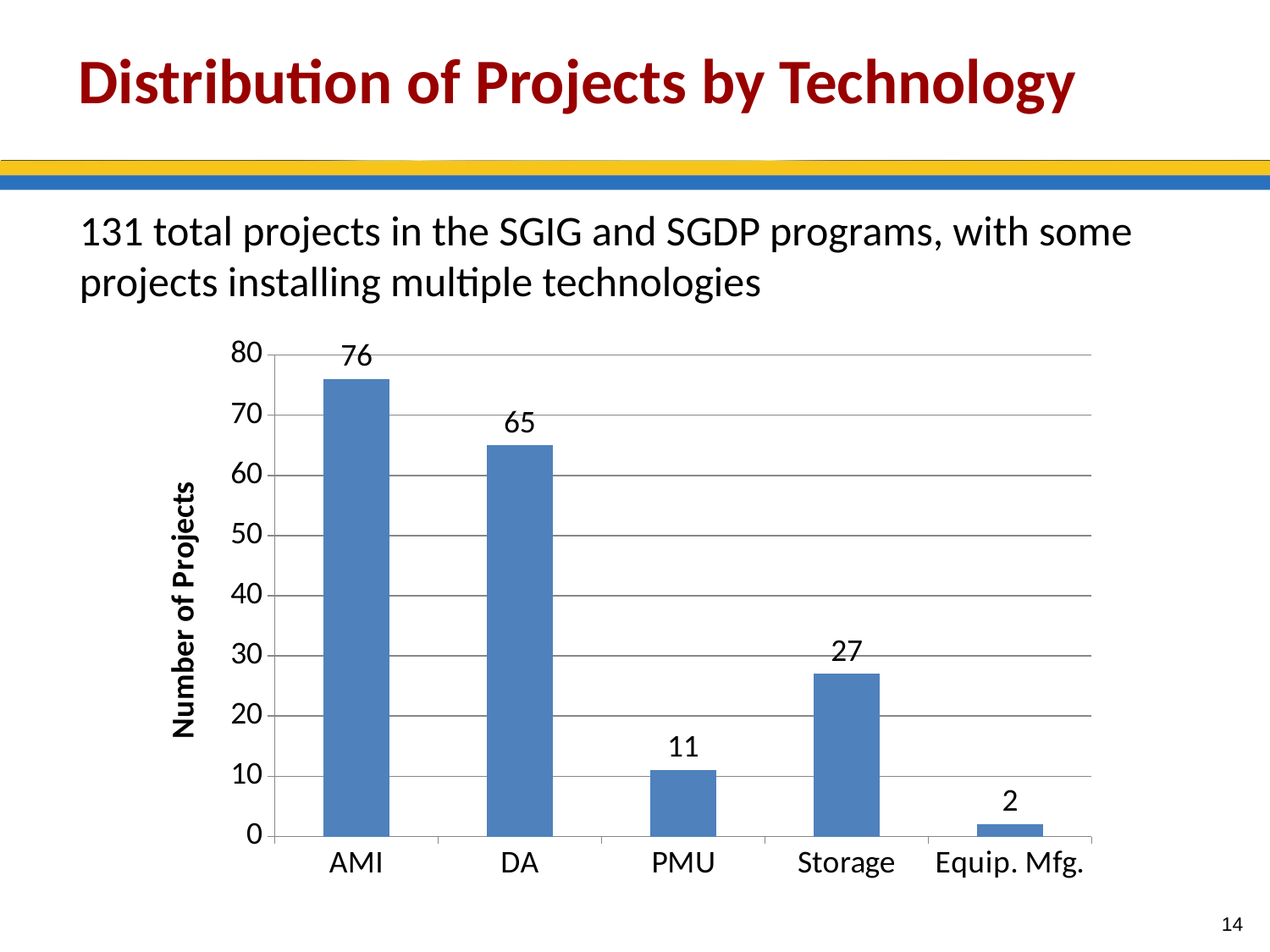
Which technology has the highest number of projects? AMI Which technology has the lowest number of projects? Equip. Mfg. What is the number of projects for Storage? 27 What is the number of projects for Equip. Mfg.? 2 What is the label of the vertical axis? Number of Projects Which has more projects, DA or Storage? DA How many technology categories are shown on the x axis? 5 What is the difference in number of projects between AMI and DA? 11 What kind of chart is shown on the slide? Bar chart Is the value for PMU greater or less than 20? less What is the number of projects for AMI? 76 What is the difference in number of projects between Storage and PMU? 16